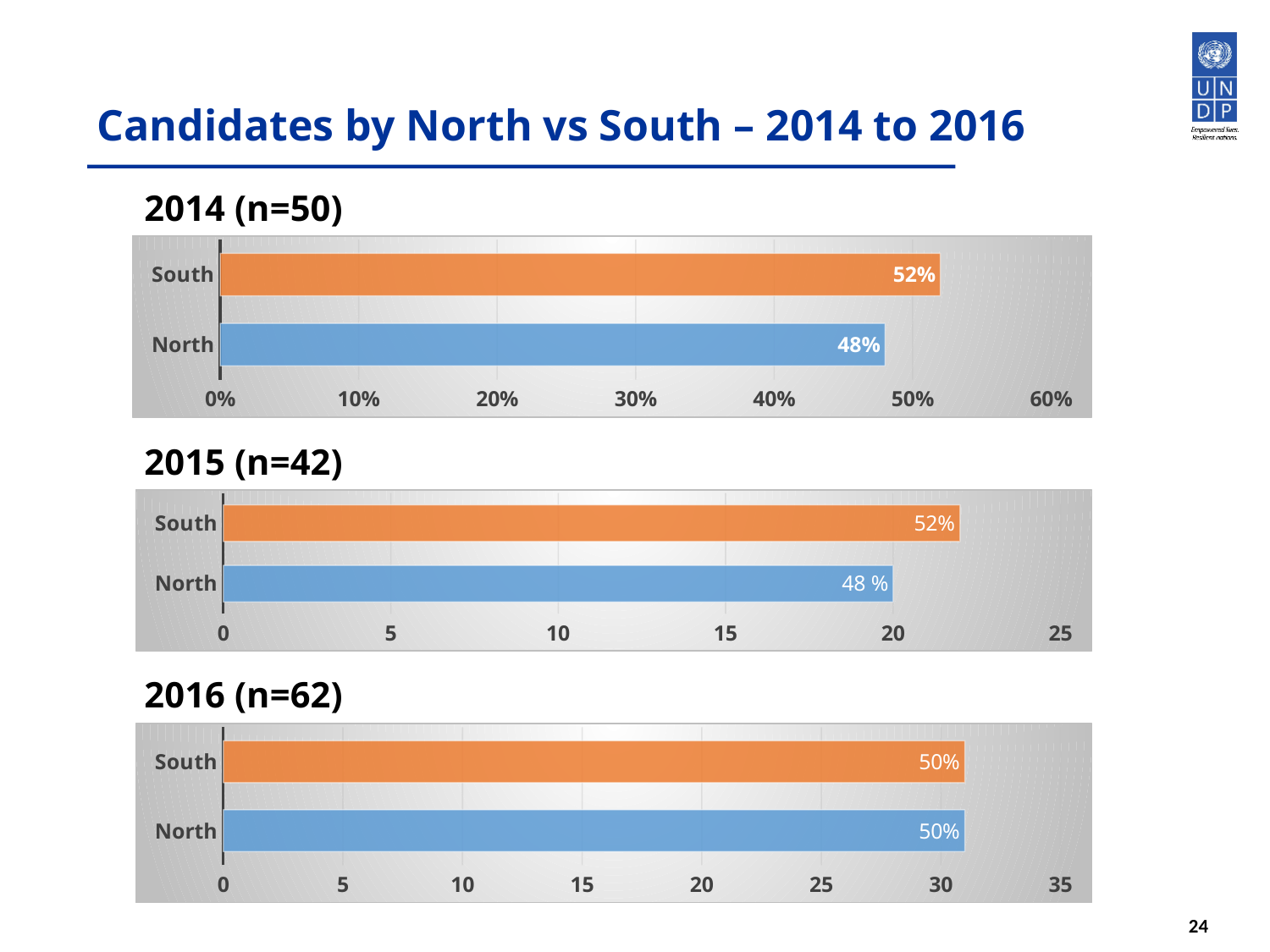
How many categories are shown in the 2014 (n=50) chart? 2 What colour is the South bar in each of the three charts? Orange What kind of chart is the 2016 (n=62) chart? Bar chart In the 2016 (n=62) chart, what is the data label on the North bar? 50% In the 2015 (n=42) chart, is the South bar greater or less than 20 on the axis? greater In the 2014 (n=50) chart, what is the value for South? 52% In the 2016 (n=62) chart, is the North bar greater or less than 30 on the axis? greater In the 2014 (n=50) chart, what is the value for North? 48% In the 2014 (n=50) chart, which category has the higher value, South or North? South In the 2015 (n=42) chart, what is the data label on the South bar? 52% In the 2014 (n=50) chart, what is the difference in percentage points between South and North? 4 percentage points In the 2015 (n=42) chart, which category has the lowest value? North